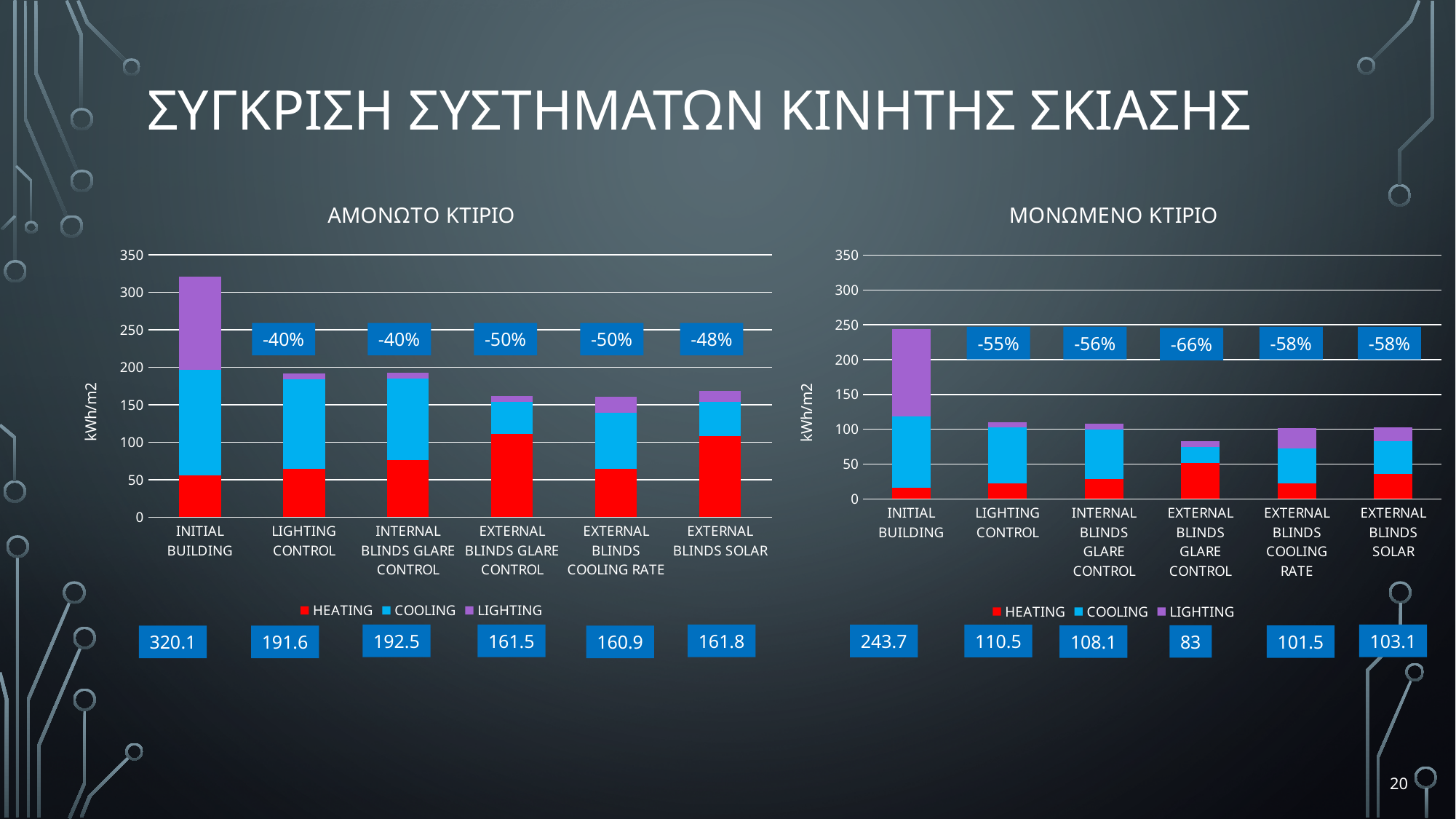
In the ΜΟΝΩΜΕΝΟ ΚΤΙΡΙΟ chart, what percentage change is printed above the INTERNAL BLINDS GLARE CONTROL bar? -56% What kind of chart is the ΑΜΟΝΩΤΟ ΚΤΙΡΙΟ chart? Stacked bar chart How many series does the legend of the ΑΜΟΝΩΤΟ ΚΤΙΡΙΟ chart list? 3 In the ΑΜΟΝΩΤΟ ΚΤΙΡΙΟ chart, what percentage change is printed above the EXTERNAL BLINDS SOLAR bar? -48% In the ΑΜΟΝΩΤΟ ΚΤΙΡΙΟ chart, what is the total value printed for INITIAL BUILDING? 320.1 Which is larger: the INITIAL BUILDING total in the ΑΜΟΝΩΤΟ ΚΤΙΡΙΟ chart or the INITIAL BUILDING total in the ΜΟΝΩΜΕΝΟ ΚΤΙΡΙΟ chart? ΑΜΟΝΩΤΟ ΚΤΙΡΙΟ How many categories are shown on the x axis of the ΜΟΝΩΜΕΝΟ ΚΤΙΡΙΟ chart? 6 What unit is shown on the y axis of both charts? kWh/m2 In the ΑΜΟΝΩΤΟ ΚΤΙΡΙΟ chart, what is the difference between the totals for INITIAL BUILDING and LIGHTING CONTROL? 128.5 In the ΜΟΝΩΜΕΝΟ ΚΤΙΡΙΟ chart, which category has the lowest total? EXTERNAL BLINDS GLARE CONTROL In the ΜΟΝΩΜΕΝΟ ΚΤΙΡΙΟ chart, which category has the highest total? INITIAL BUILDING In the ΜΟΝΩΜΕΝΟ ΚΤΙΡΙΟ chart, what is the total value printed for EXTERNAL BLINDS GLARE CONTROL? 83